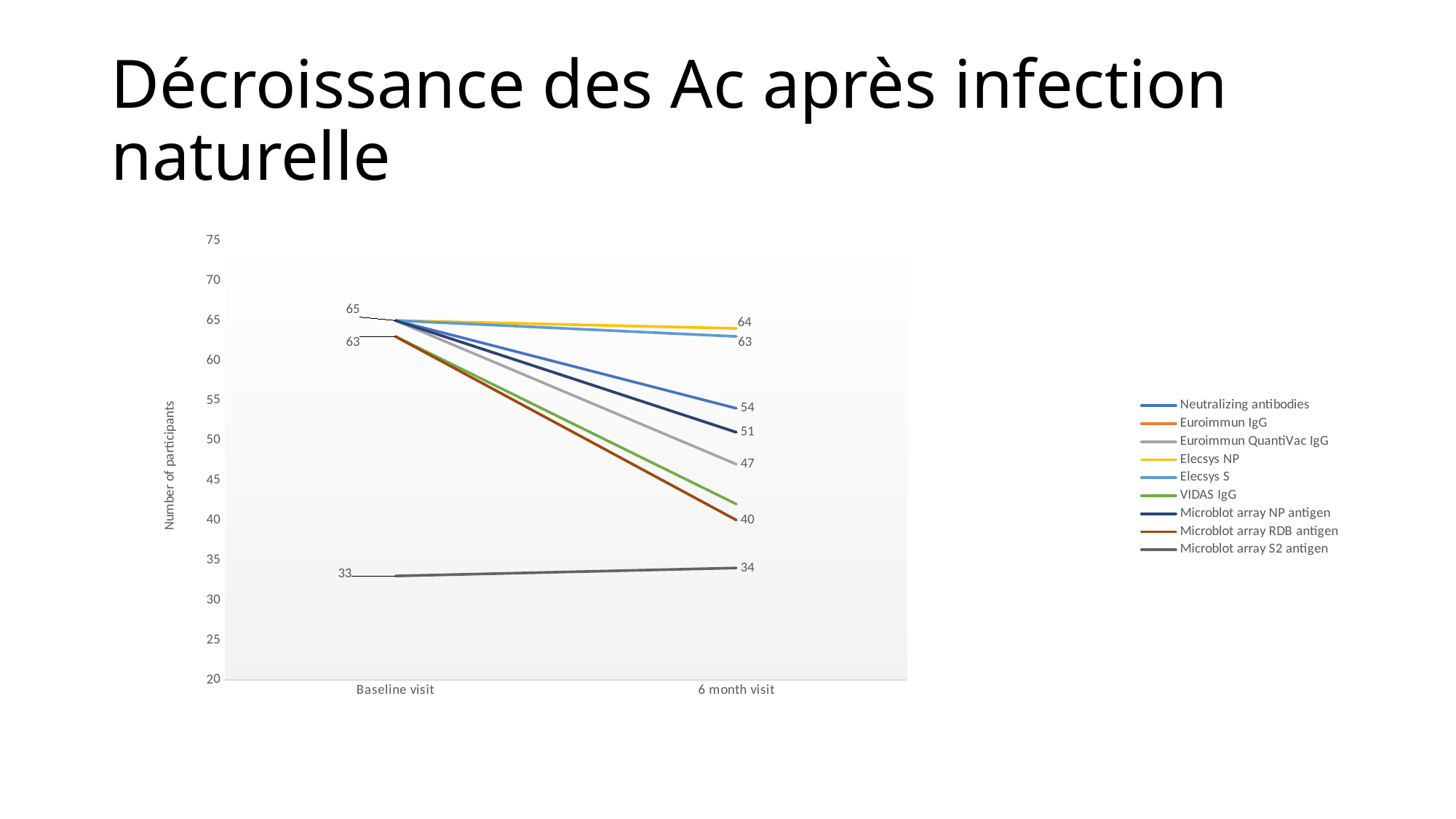
Does the Neutralizing antibodies line rise or fall from the Baseline visit to the 6 month visit? fall What is the value for Euroimmun QuantiVac IgG at the 6 month visit? 47 What is the value for Neutralizing antibodies at the 6 month visit? 54 How many visits (x-axis categories) are plotted? 2 What is the value for Microblot array S2 antigen at the Baseline visit? 33 What is the value for Microblot array NP antigen at the 6 month visit? 51 What kind of chart is shown on the slide? line chart How many series does the legend list? 9 By how much does Neutralizing antibodies decrease from the Baseline visit (65) to the 6 month visit (54)? 11 Which series has the lowest value at the 6 month visit? Microblot array S2 antigen What is the value for Microblot array S2 antigen at the 6 month visit? 34 Is the value for VIDAS IgG at the 6 month visit greater or less than 45? less